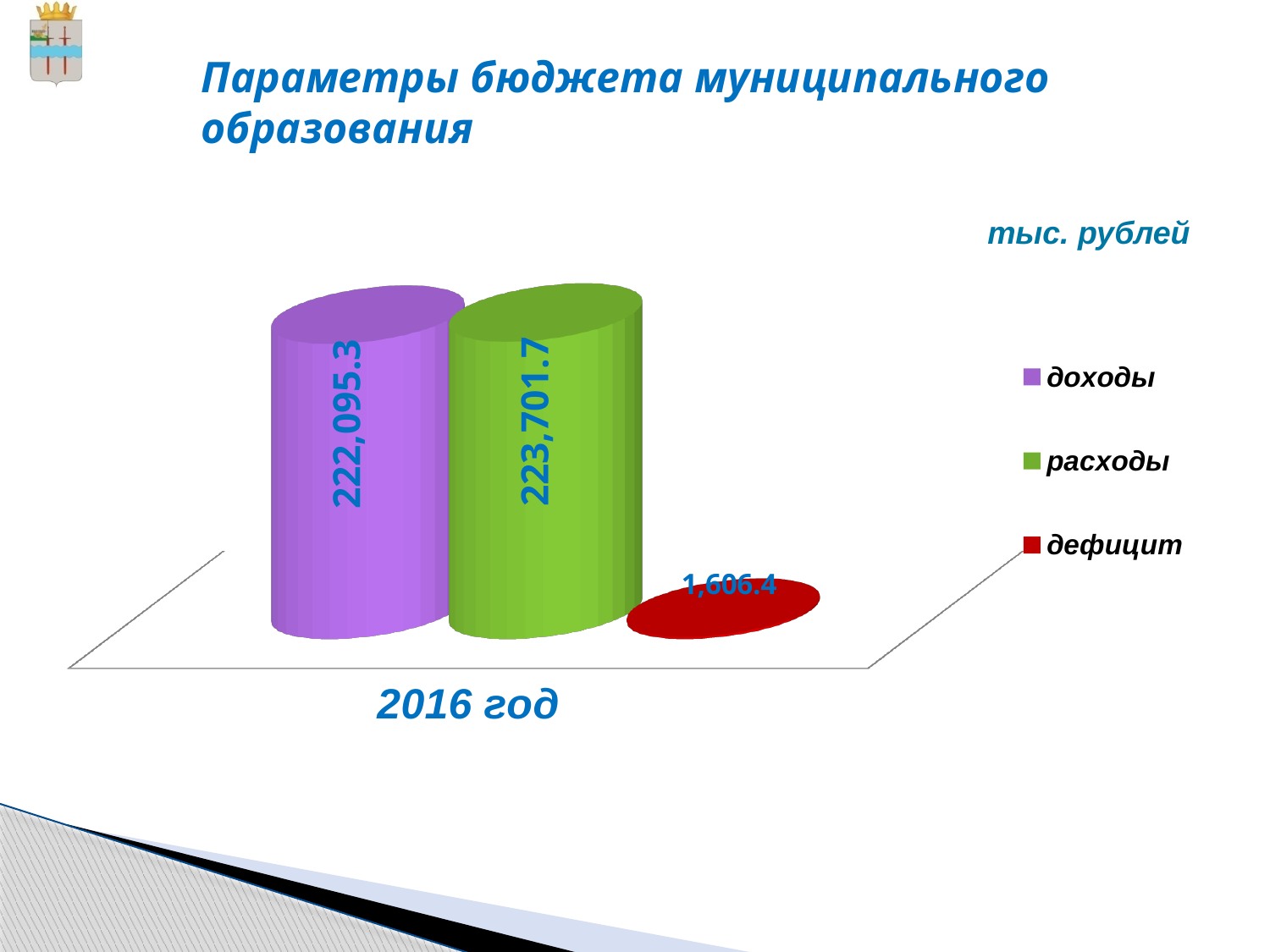
Which series has the lowest value in 2016 год? дефицит Which series has the highest value in 2016 год? расходы What is the difference between расходы and доходы in 2016 год? 1,606.4 What colour represents дефицит in the legend? red What is the value for доходы in 2016 год? 222,095.3 What unit is stated for the chart values? тыс. рублей What is the value for расходы in 2016 год? 223,701.7 What kind of chart is shown on the slide? bar chart How many series does the legend list? 3 What is the value for дефицит in 2016 год? 1,606.4 Which is larger in 2016 год, доходы or расходы? расходы How many categories are shown on the x axis? 1